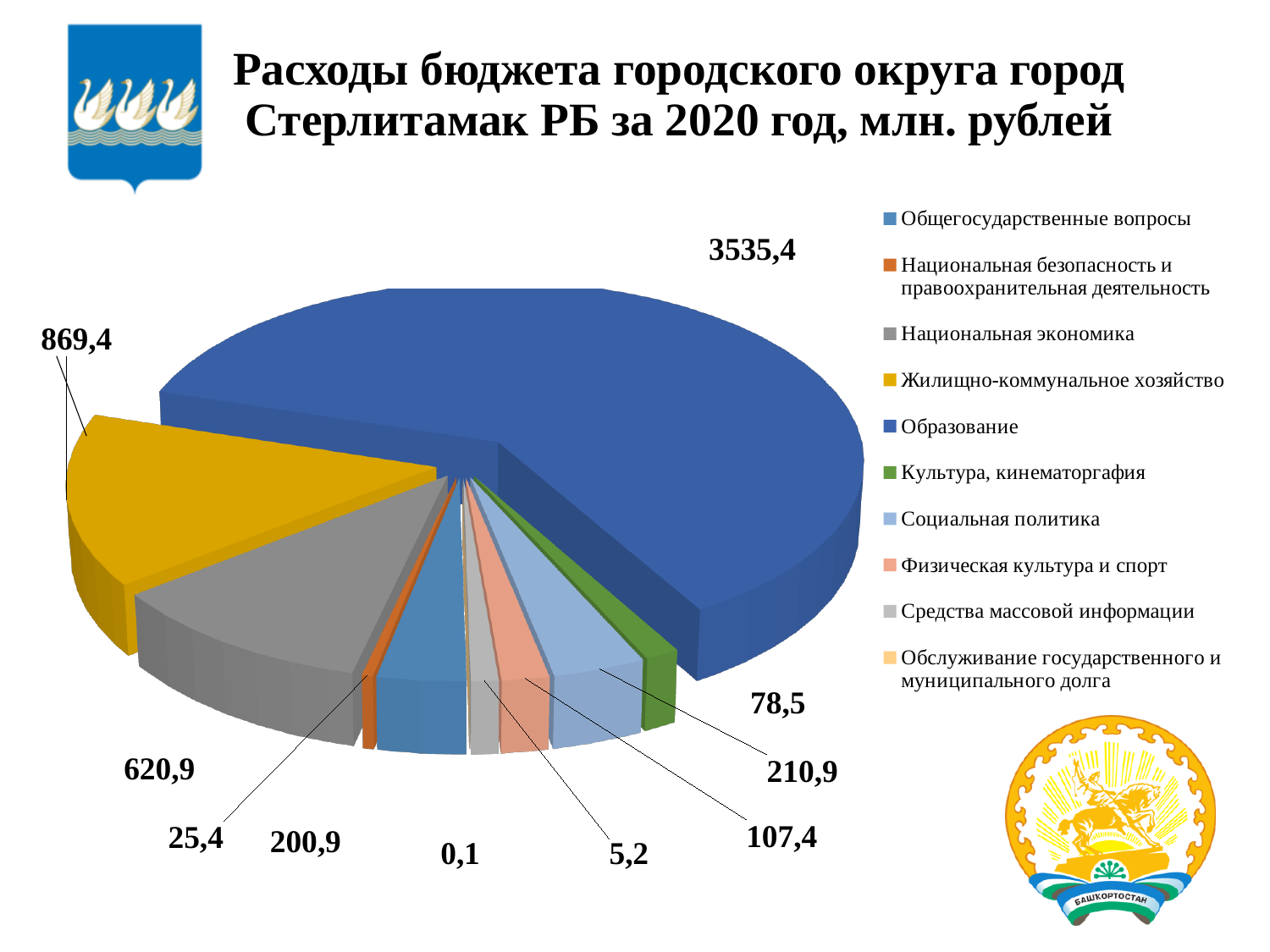
What is the value for Национальная экономика? 620,9 What is the difference between Жилищно-коммунальное хозяйство and Национальная экономика? 248,5 What is the value for Культура, кинематоргафия? 78,5 What is the value for Физическая культура и спорт? 107,4 What is the difference between Образование and Жилищно-коммунальное хозяйство? 2666,0 What is the title of the slide? Расходы бюджета городского округа город Стерлитамак РБ за 2020 год, млн. рублей What is the value for Жилищно-коммунальное хозяйство? 869,4 Which category has the largest share of the pie? Образование What kind of chart is shown on the slide? pie chart Which is larger: Социальная политика or Общегосударственные вопросы? Социальная политика What is the value for Образование? 3535,4 How many categories does the legend list? 10